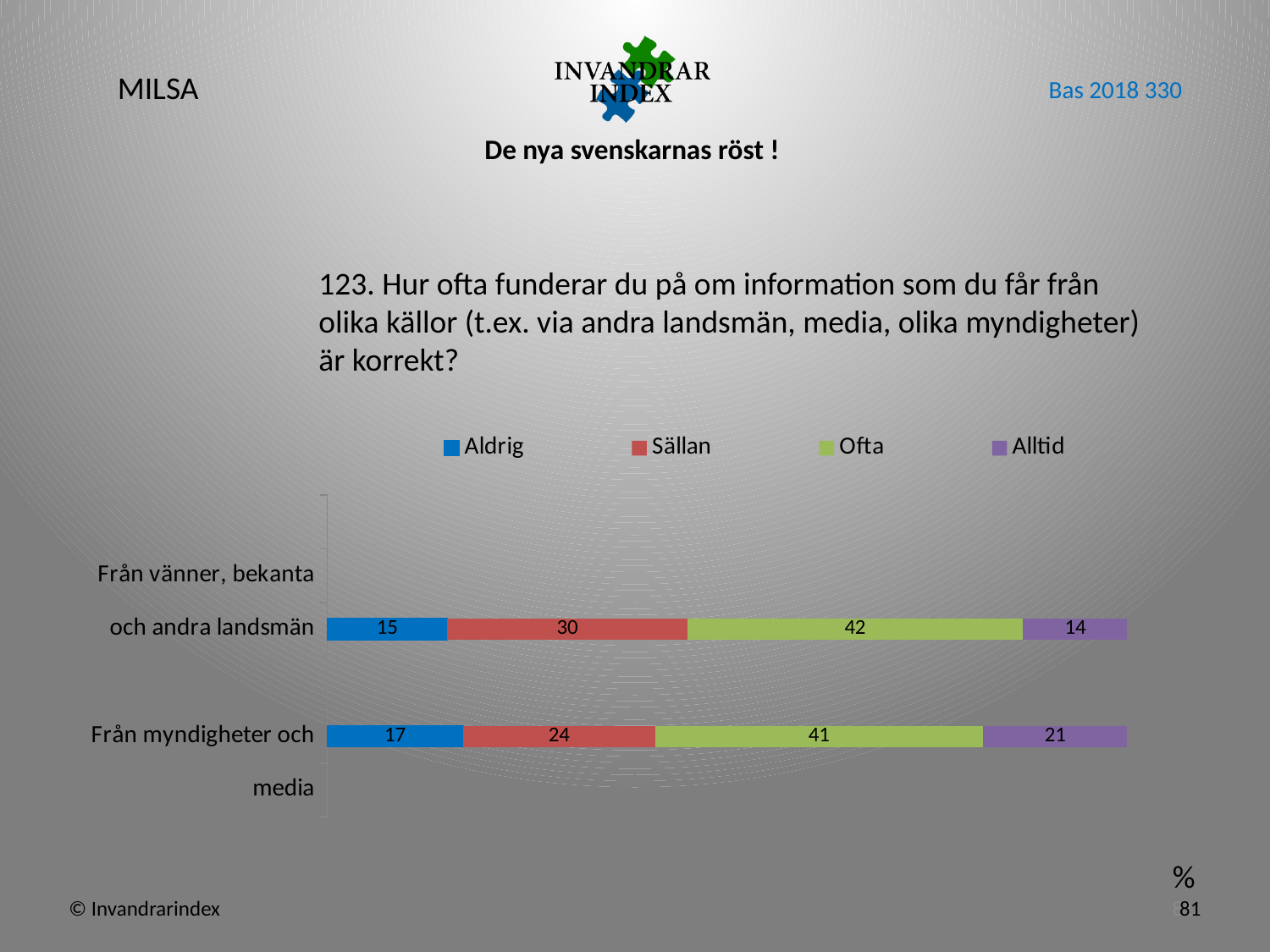
What is the value for Aldrig in the category 'Från myndigheter och media'? 17 How many categories are plotted on the chart? 2 What is the difference between the Sällan values for 'Från vänner, bekanta och andra landsmän' and 'Från myndigheter och media'? 6 What is the value for Ofta in the category 'Från vänner, bekanta och andra landsmän'? 42 Which category has the larger Alltid value, 'Från vänner, bekanta och andra landsmän' or 'Från myndigheter och media'? Från myndigheter och media What is the value for Sällan in the category 'Från vänner, bekanta och andra landsmän'? 30 What kind of chart is shown on the slide? Stacked bar chart Which series has the highest value in the category 'Från myndigheter och media'? Ofta What is the value for Alltid in the category 'Från myndigheter och media'? 21 Which series has the lowest value in the category 'Från vänner, bekanta och andra landsmän'? Alltid Which legend entry is shown in purple? Alltid How many series does the legend list? 4